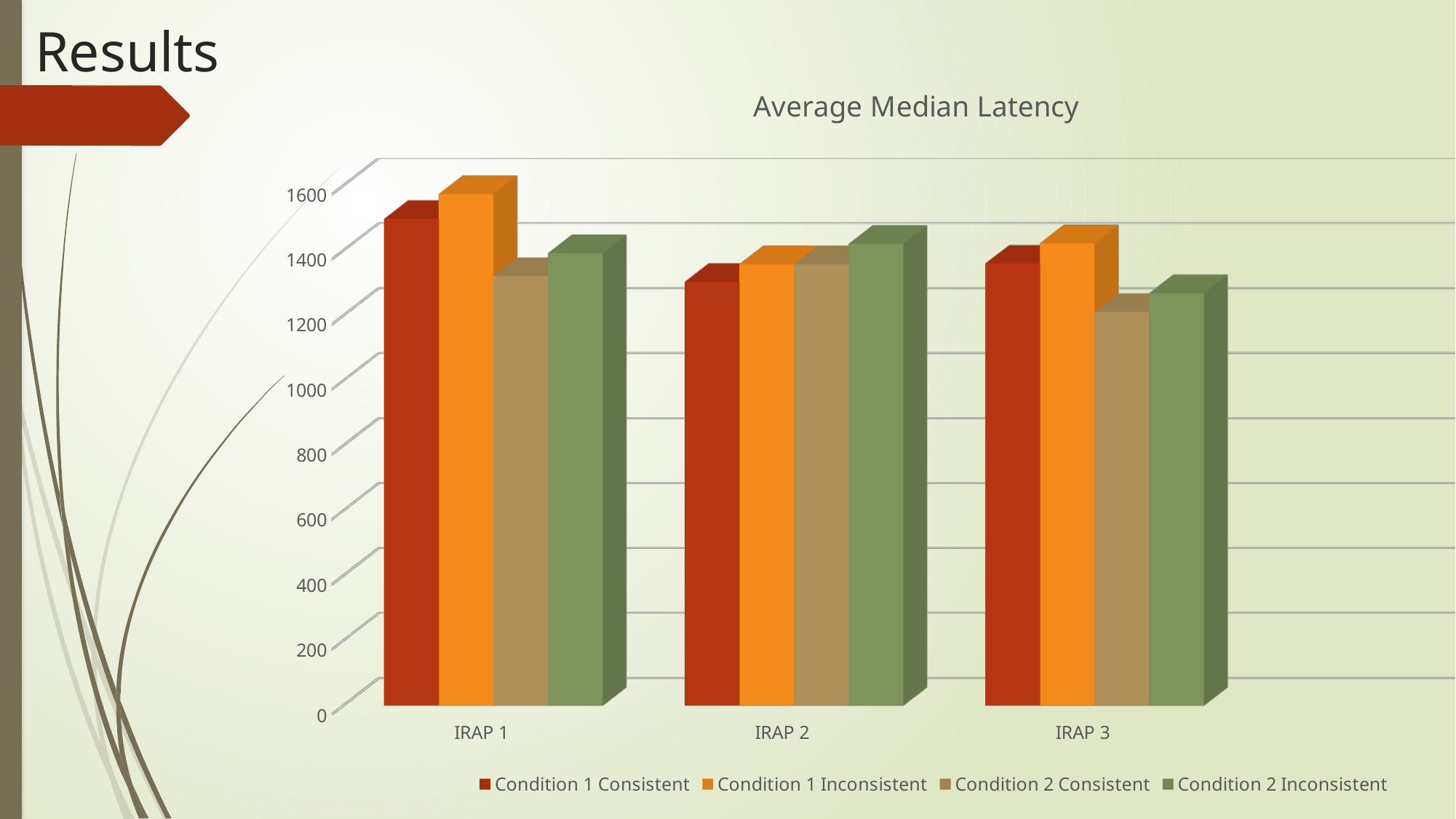
Is the value for Condition 1 Consistent at IRAP 1 greater or less than 1400? greater What kind of chart is shown on the slide? bar chart Which is larger: Condition 1 Consistent at IRAP 1 or Condition 2 Consistent at IRAP 3? Condition 1 Consistent at IRAP 1 Which series has the highest value for IRAP 1? Condition 1 Inconsistent Which series has the lowest value for IRAP 3? Condition 2 Consistent Is the value for Condition 2 Consistent at IRAP 3 greater or less than 1400? less Which series is shown in orange in the legend? Condition 1 Inconsistent What is the title of the chart? Average Median Latency How many categories are shown on the x axis of the chart? 3 Does the value for Condition 1 Consistent rise or fall from IRAP 1 to IRAP 2? fall How many series does the chart's legend list? 4 Is the value for Condition 1 Inconsistent at IRAP 1 greater or less than 1400? greater